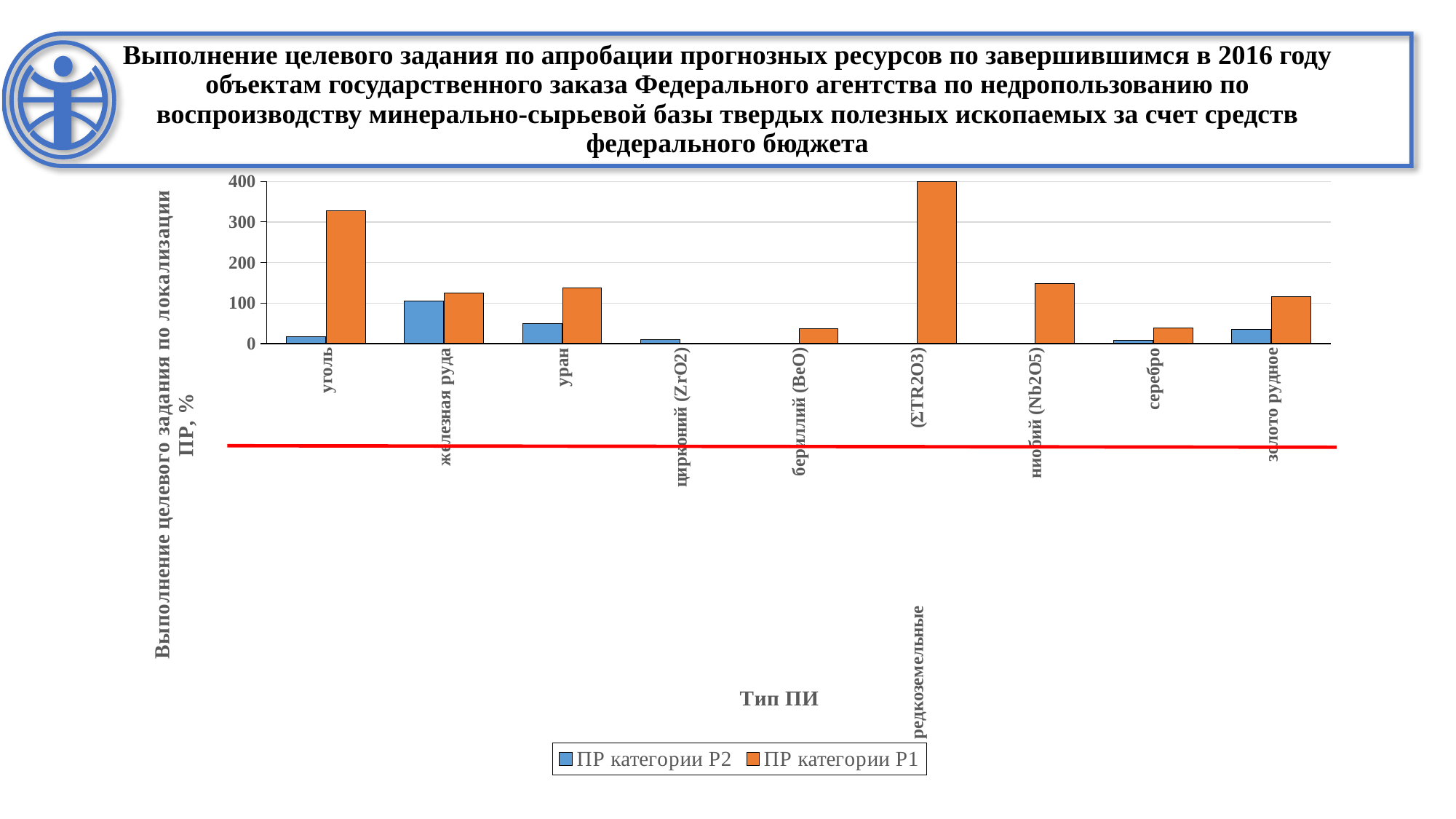
Which category has the highest value for ПР категории Р2? железная руда What colour are the bars for ПР категории Р1? orange Is the value of ПР категории Р2 for уран greater or less than 100? less Which is larger: ПР категории Р1 for уголь or ПР категории Р1 for золото рудное? уголь Is the value of ПР категории Р1 for уголь greater or less than 300? greater Is the value of ПР категории Р1 for серебро greater or less than 100? less How many mineral types (categories) are shown on the x axis? 9 Which category has the highest value for ПР категории Р1? редкоземельные (ΣTR2O3) How many series does the legend list? 2 For уголь, which series has the larger value: ПР категории Р2 or ПР категории Р1? ПР категории Р1 What kind of chart is shown on the slide? bar chart